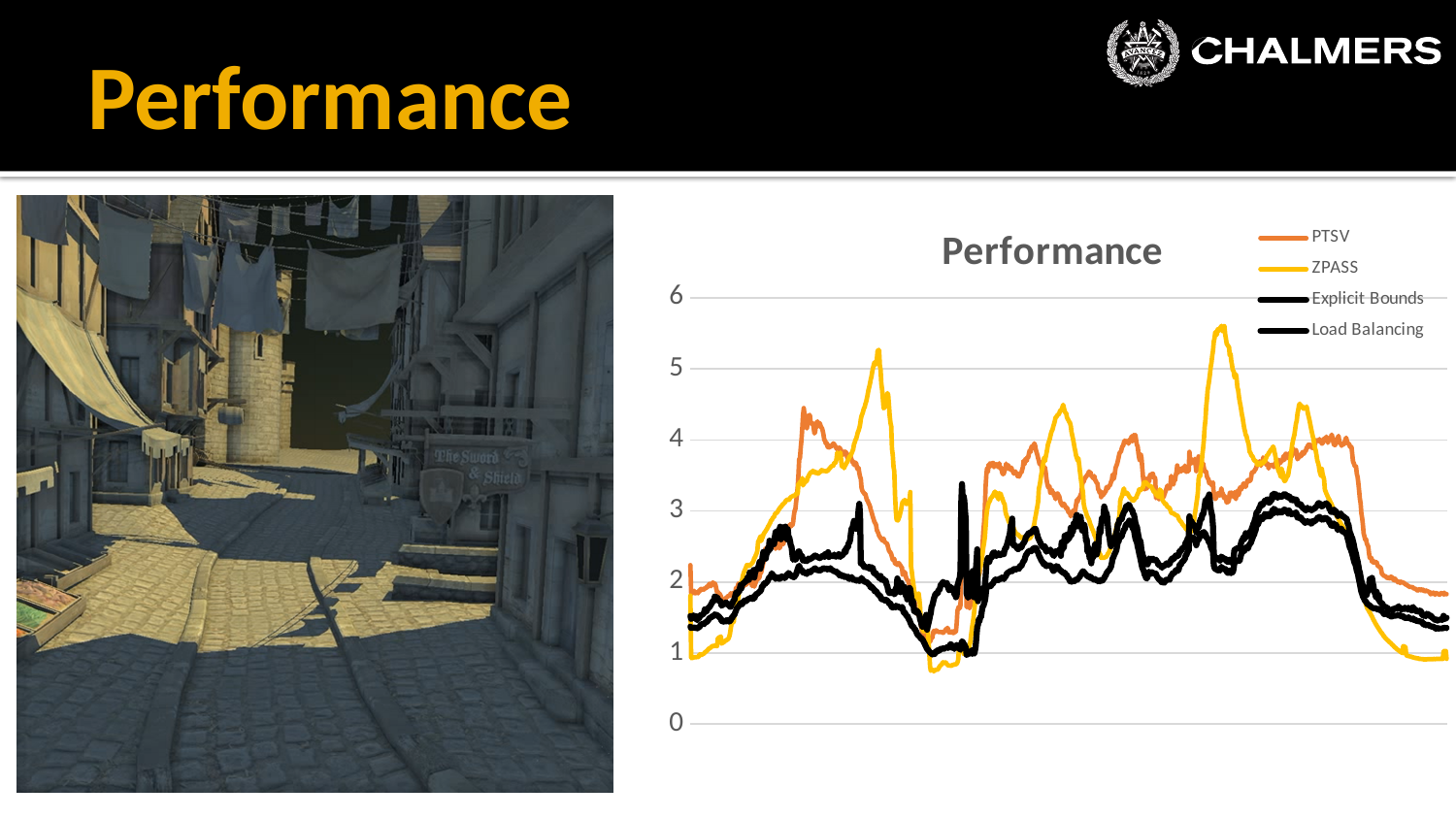
How many series does the chart's legend list? 4 What kind of chart is shown on the slide? line chart Is the lowest value reached by the ZPASS series greater or less than 1? less Which series in the legend is drawn in orange? PTSV What is the title of the chart? Performance Is the highest value reached by the ZPASS series greater or less than 5? greater Is the highest value reached by the Explicit Bounds series greater or less than 4? less What is the highest tick value shown on the vertical axis? 6 Which series reaches the highest value anywhere on the chart? ZPASS Which series reaches a higher peak value, ZPASS or PTSV? ZPASS